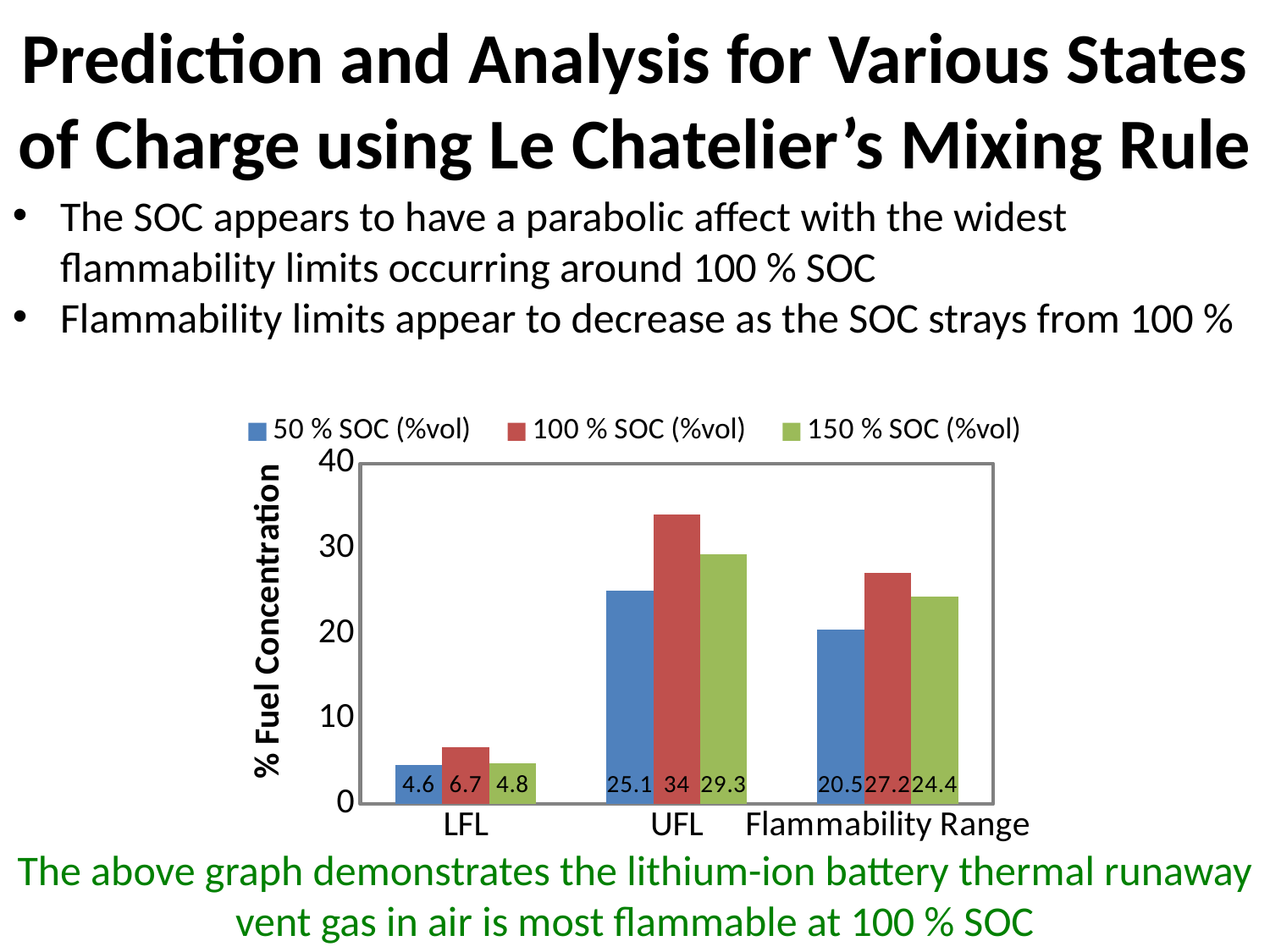
Which is larger in the LFL category: the 150 % SOC (%vol) value or the 50 % SOC (%vol) value? 150 % SOC (%vol) What is the value for 150 % SOC (%vol) in the Flammability Range category? 24.4 Which series has the highest value in the UFL category? 100 % SOC (%vol) How many categories are shown on the x axis? 3 What is the value for 50 % SOC (%vol) in the LFL category? 4.6 What is the value for 100 % SOC (%vol) in the UFL category? 34 What is the label of the y axis? % Fuel Concentration What type of chart is shown on the slide? bar chart How many series does the legend list? 3 Which series has the lowest value in the Flammability Range category? 50 % SOC (%vol) Is the value for 150 % SOC (%vol) in the UFL category greater or less than 20? greater What is the difference between the 100 % SOC (%vol) and 50 % SOC (%vol) values in the UFL category? 8.9